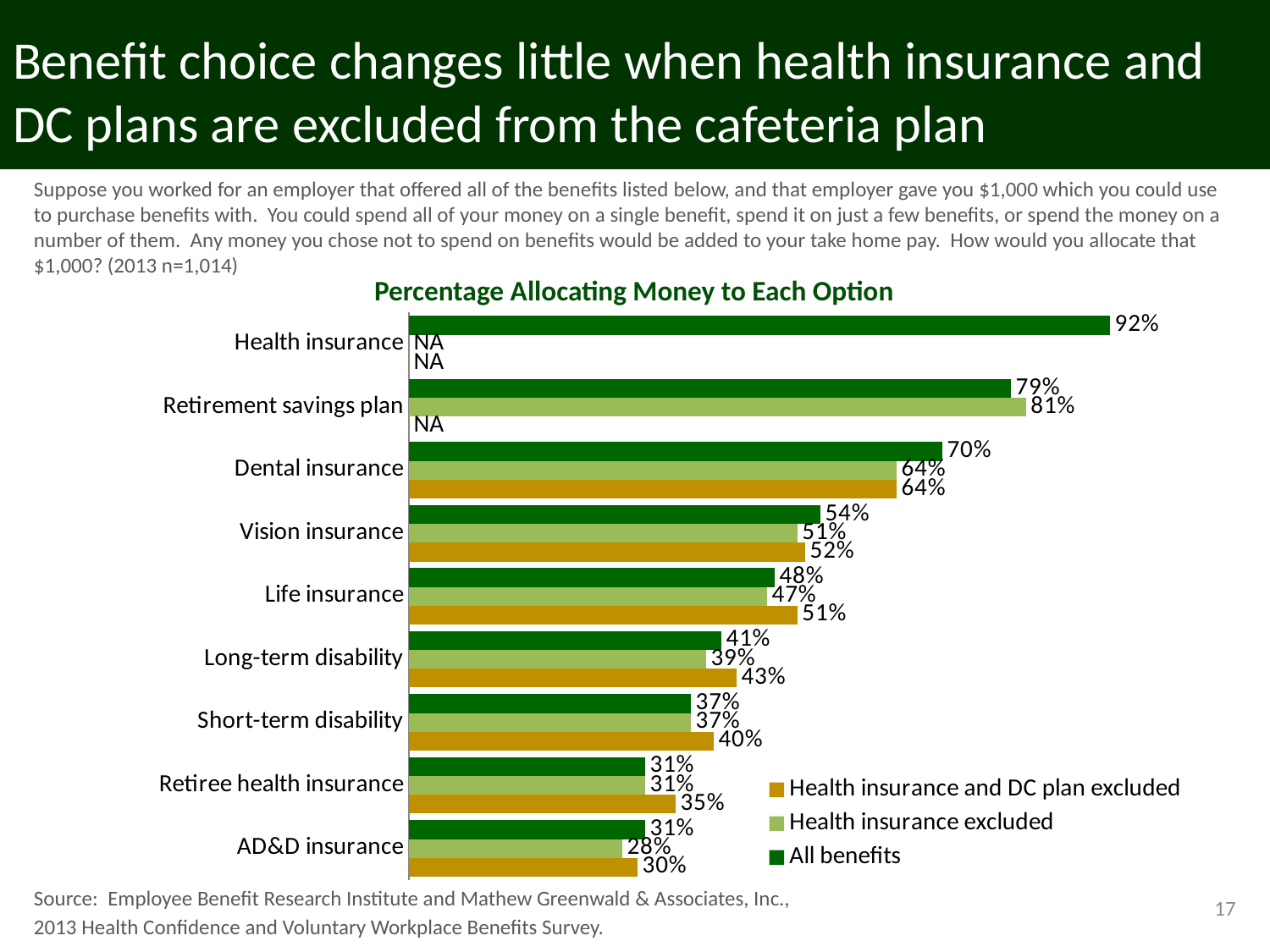
For Life insurance, which is larger: the All benefits value or the Health insurance and DC plan excluded value? Health insurance and DC plan excluded What is the value for Retirement savings plan in the Health insurance excluded series? 81% Which benefit option has the highest value in the All benefits series? Health insurance What kind of chart is shown on the slide? Bar chart What is the value for Long-term disability in the Health insurance and DC plan excluded series? 43% What percentage allocated money to Health insurance under the All benefits scenario? 92% What is the difference between the All benefits value and the Health insurance excluded value for Dental insurance? 6% How many series does the legend list? 3 What value is shown for Health insurance in the Health insurance and DC plan excluded series? NA What is the title of the chart? Percentage Allocating Money to Each Option How many benefit options are listed on the chart? 9 Which benefit option has the lowest value in the Health insurance excluded series? AD&D insurance